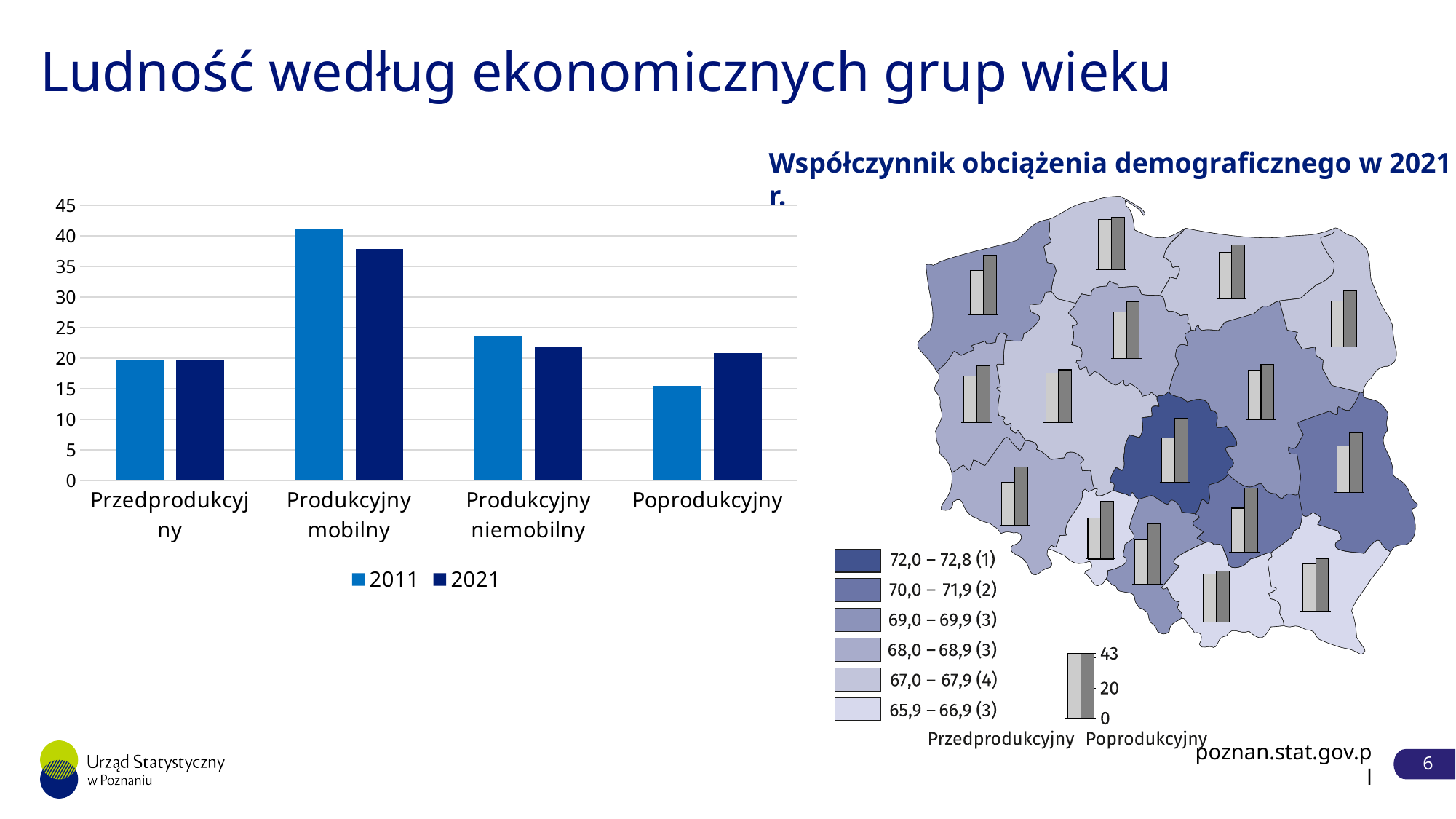
In the bar chart on the left, which category has the lowest value for 2011? Poprodukcyjny In the bar chart on the left, which category has the highest value for 2021? Produkcyjny mobilny In the bar chart on the left, for Produkcyjny mobilny, which year has the larger value, 2011 or 2021? 2011 What are the two legend entries of the bar chart on the left? 2011 and 2021 What kind of chart is the chart on the left of the slide? bar chart In the bar chart on the left, is the 2011 value for Poprodukcyjny greater or less than 20? less How many categories are shown on the x axis of the bar chart on the left? 4 In the bar chart on the left, is the 2021 value for Produkcyjny mobilny greater or less than 40? less In the bar chart on the left, for Poprodukcyjny, which year has the larger value, 2011 or 2021? 2021 In the bar chart on the left, which category has the highest value for 2011? Produkcyjny mobilny How many series does the legend of the bar chart on the left list? 2 In the bar chart on the left, is the 2011 value for Produkcyjny mobilny greater or less than 35? greater